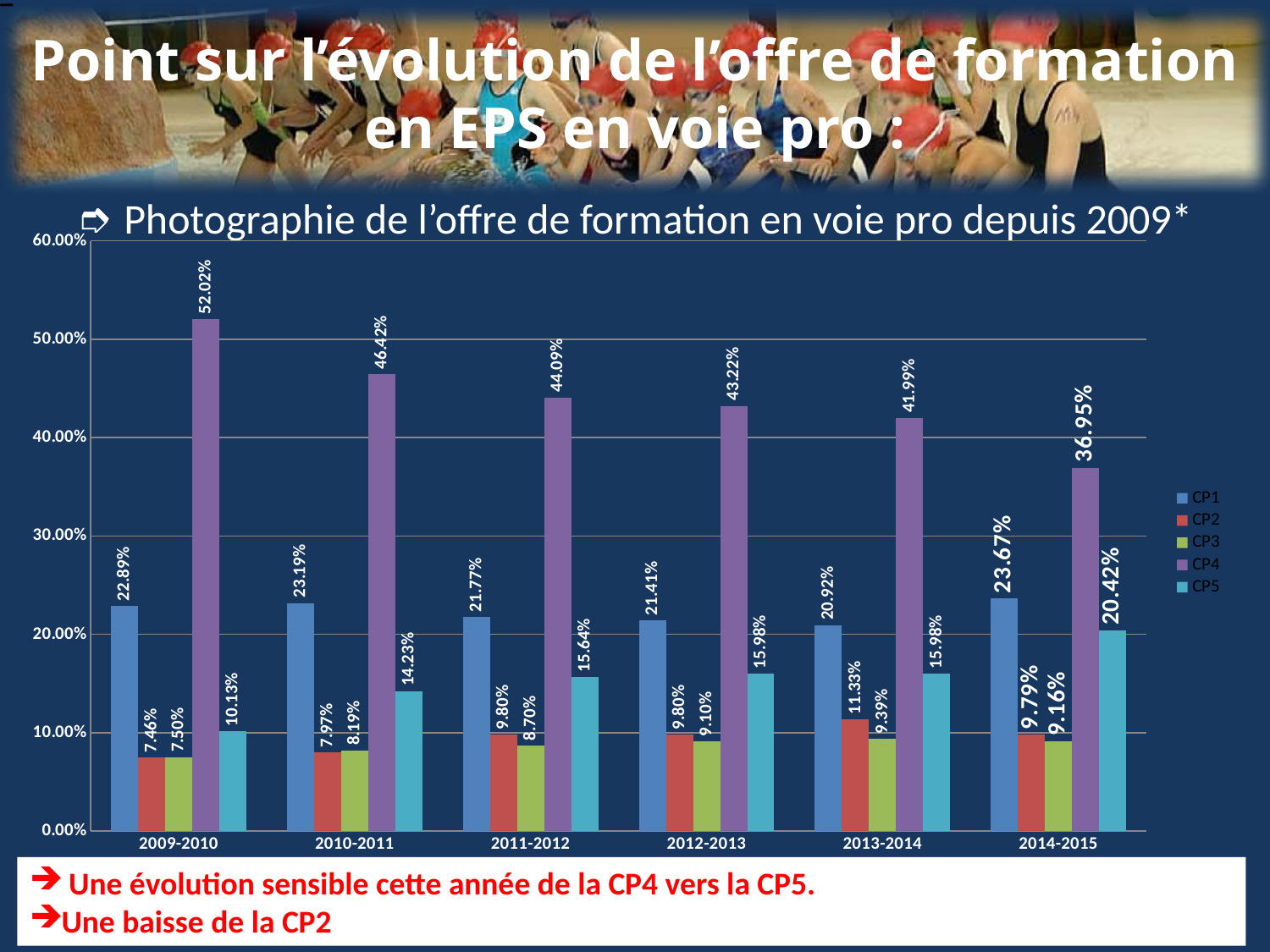
In which year is the CP4 value highest? 2009-2010 What is the value for CP5 in 2014-2015? 20.42% Which is larger in 2014-2015, CP1 or CP5? CP1 What is the value for CP4 in 2009-2010? 52.02% What is the difference between the CP4 values in 2009-2010 and 2014-2015? 15.07% How many year categories are shown on the x axis? 6 What kind of chart is shown on the slide? bar chart Which series is shown in purple in the legend? CP4 How many series does the legend list? 5 In which year is the CP5 value lowest? 2009-2010 What is the value for CP2 in 2013-2014? 11.33% Does the CP4 value rise or fall from 2009-2010 to 2014-2015? fall